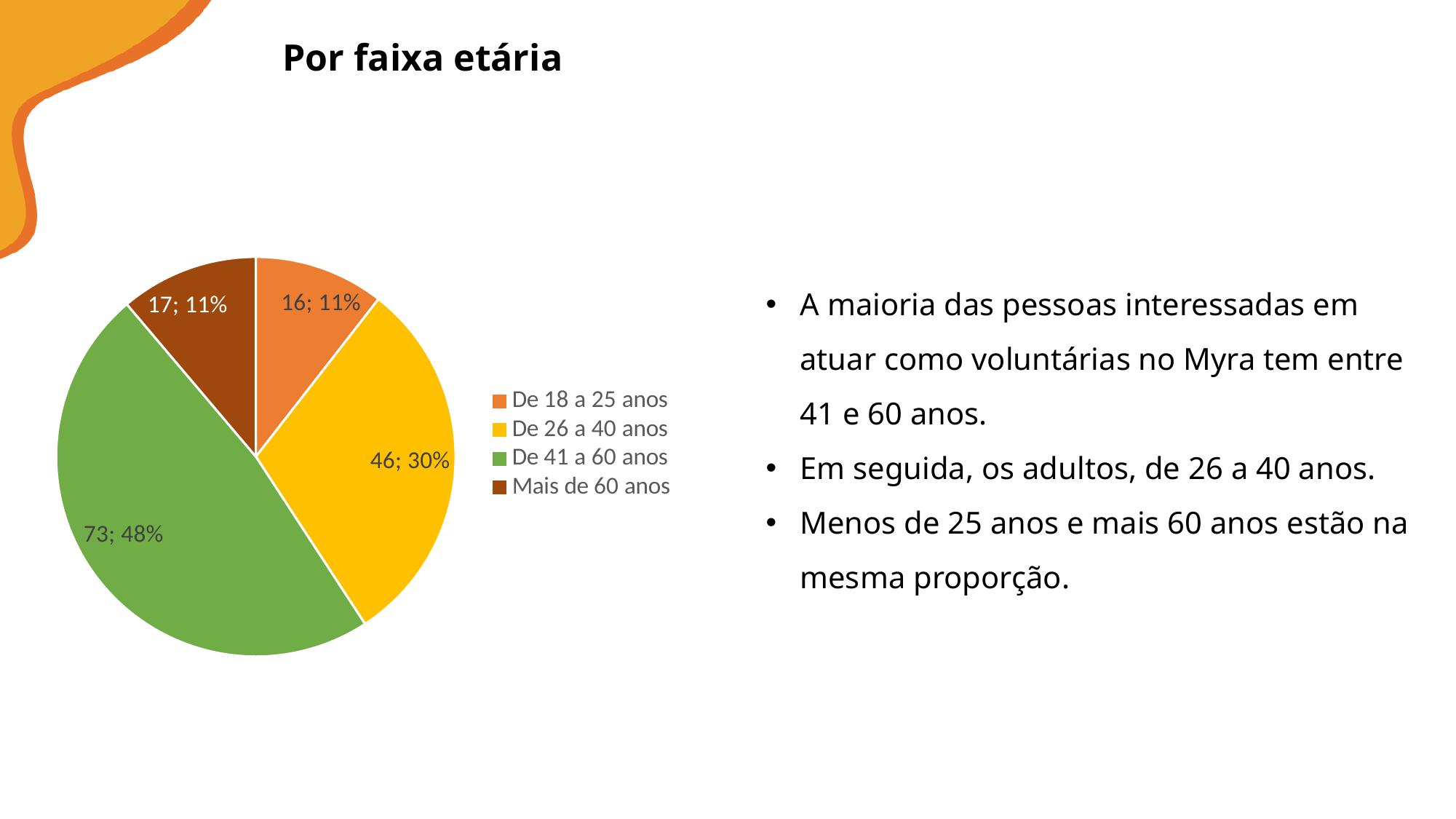
What percentage share does the 'De 18 a 25 anos' slice represent? 11% What is the difference in count between 'De 41 a 60 anos' and 'De 26 a 40 anos'? 27 What kind of chart is shown on the slide? Pie chart What is the count for the 'Mais de 60 anos' slice? 17 What is the total count across all slices of the pie chart? 152 How many slices does the pie chart have? 4 What colour is the 'De 41 a 60 anos' slice? Green What percentage share does the 'De 26 a 40 anos' slice represent? 30% Which age group has the smallest count? De 18 a 25 anos Which age group has the largest slice? De 41 a 60 anos What is the count for the 'De 41 a 60 anos' slice? 73 Which has a larger count, 'De 26 a 40 anos' or 'Mais de 60 anos'? De 26 a 40 anos